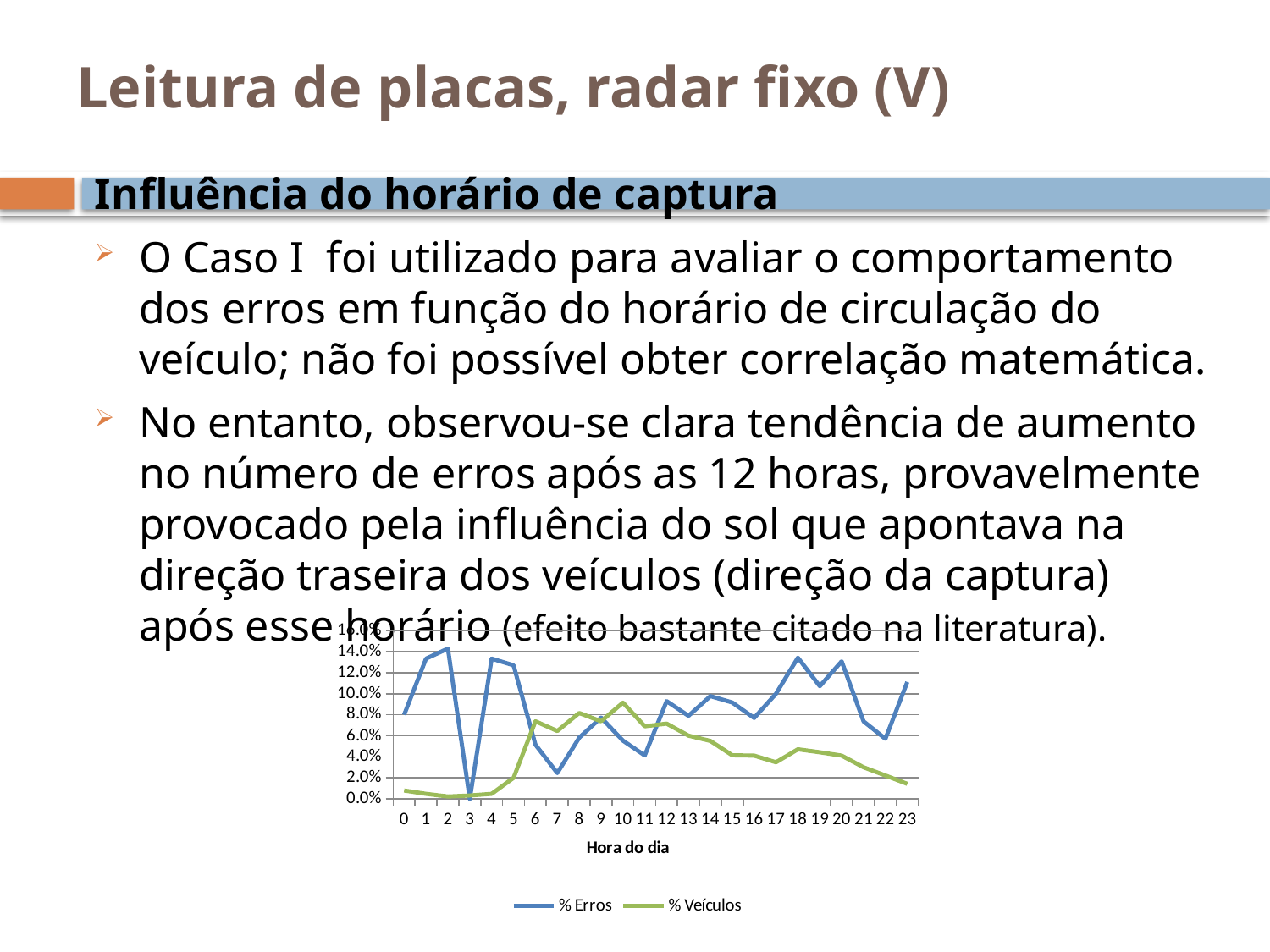
Is the % Veículos value at hour 0 greater or less than 2.0%? less At hour 7, which series has the higher value, % Erros or % Veículos? % Veículos How many series does the chart legend list? 2 How many hours are plotted along the x axis of the chart? 24 Is the % Erros value at hour 3 greater or less than 2.0%? less At hour 18, which series has the higher value, % Erros or % Veículos? % Erros At which hour does the % Erros series reach its lowest value? 3 What kind of chart is shown on the slide? line chart Is the % Veículos value at hour 10 greater or less than 6.0%? greater What is the title of the x axis of the chart? Hora do dia Does the % Veículos series rise or fall from hour 10 to hour 23? fall